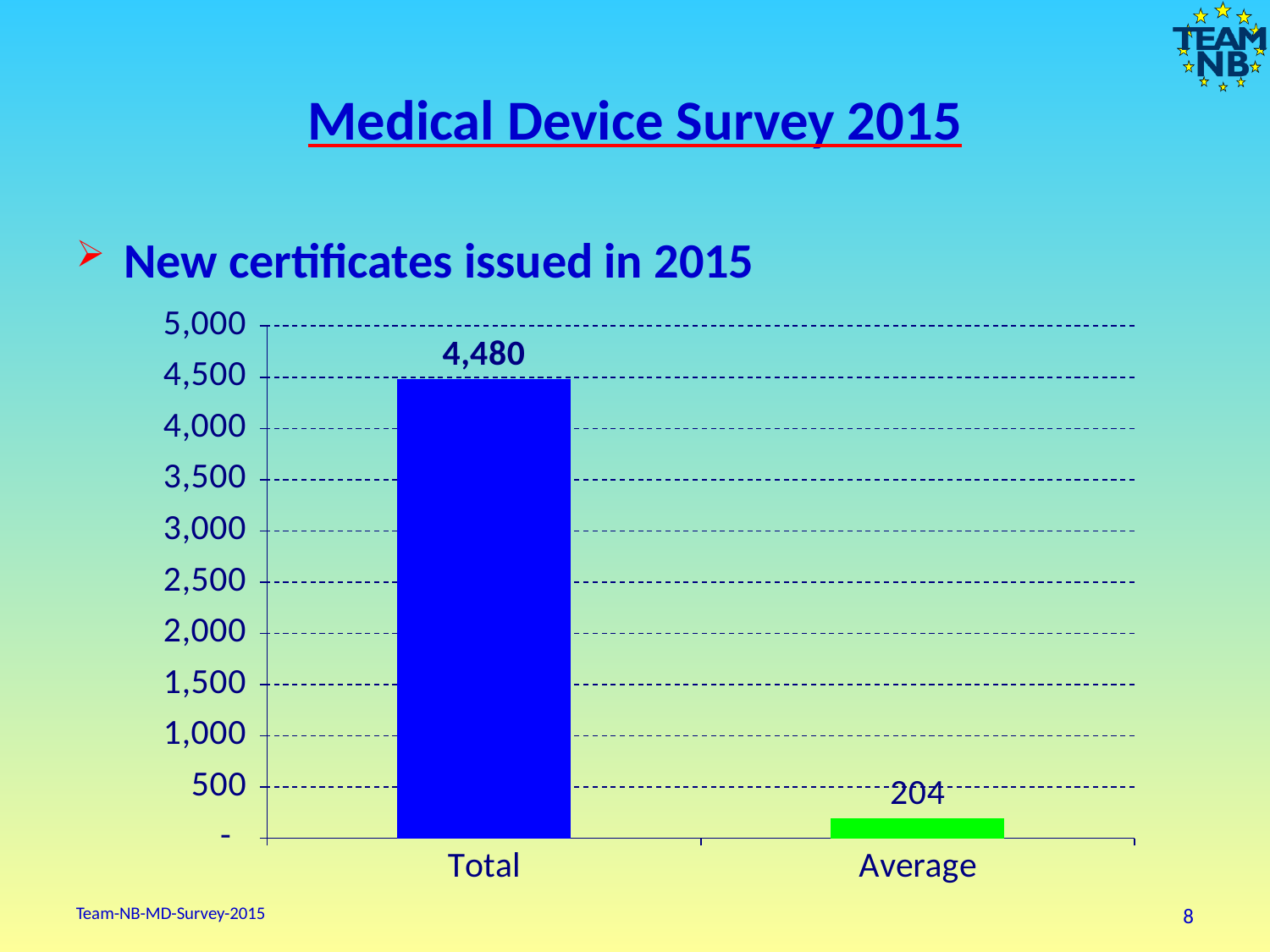
Is the value for Total greater or less than 4,000? greater What is the heading above the chart? New certificates issued in 2015 Is the value for Average greater or less than 500? less What is the difference between the Total and Average values? 4,276 What kind of chart is shown on the slide? bar chart What is the value for Average? 204 Which is larger, the value for Total or the value for Average? Total How many categories are shown on the x axis? 2 What is the value for Total? 4,480 Which category has the highest value? Total Which category has the lowest value? Average What colour is the bar for Average? green